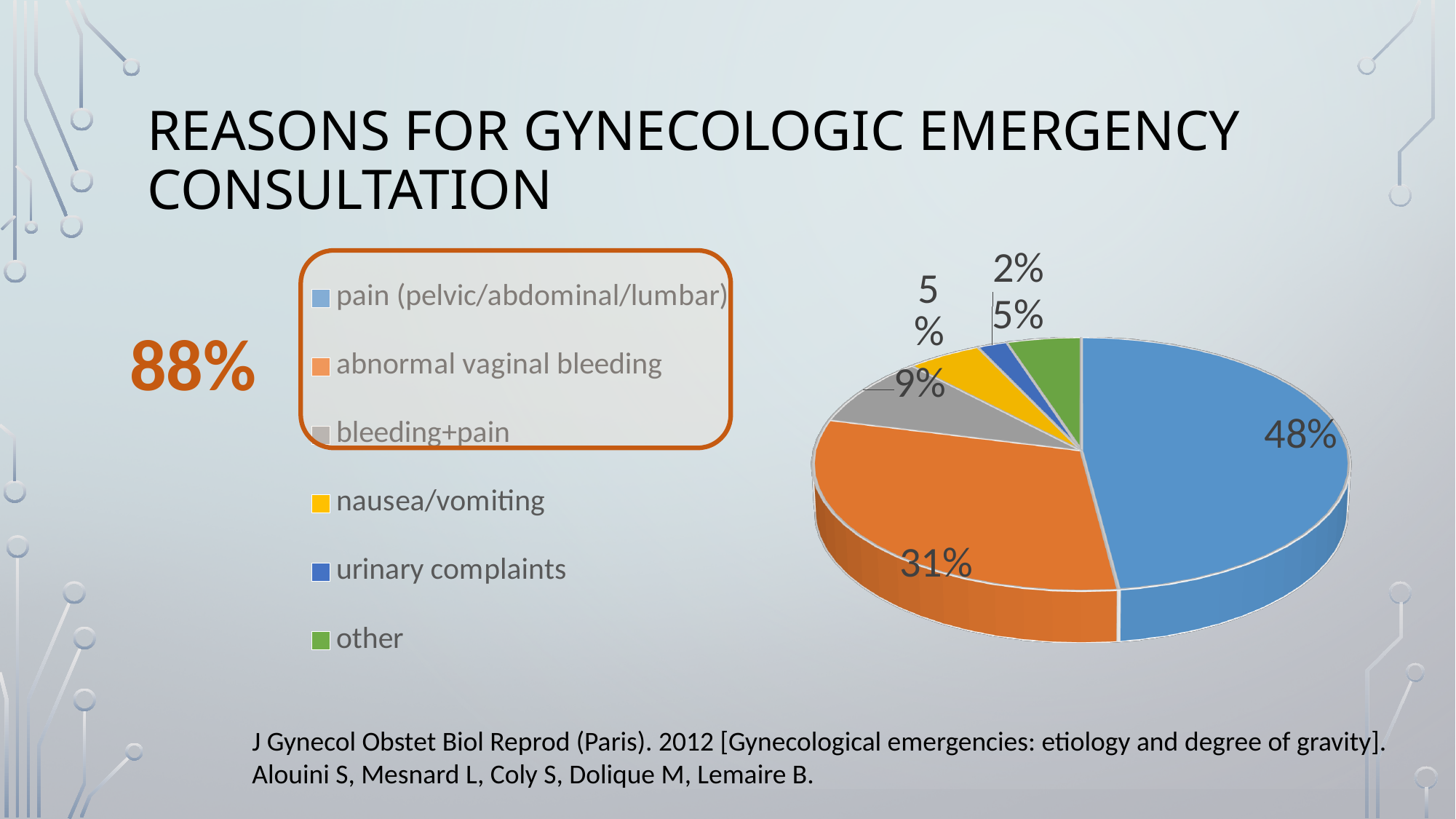
What share of the pie is nausea/vomiting? 5% What share of the pie is abnormal vaginal bleeding? 31% What share of the pie is pain (pelvic/abdominal/lumbar)? 48% Which category has the smallest slice of the pie? urinary complaints How many categories does the legend list? 6 Which category has the largest slice of the pie? pain (pelvic/abdominal/lumbar) What kind of chart is shown on the slide? pie chart What is the title of the slide containing the chart? Reasons for gynecologic emergency consultation What is the difference in percentage points between pain (pelvic/abdominal/lumbar) and abnormal vaginal bleeding? 17 Which is larger, the slice for bleeding+pain or the slice for other? bleeding+pain